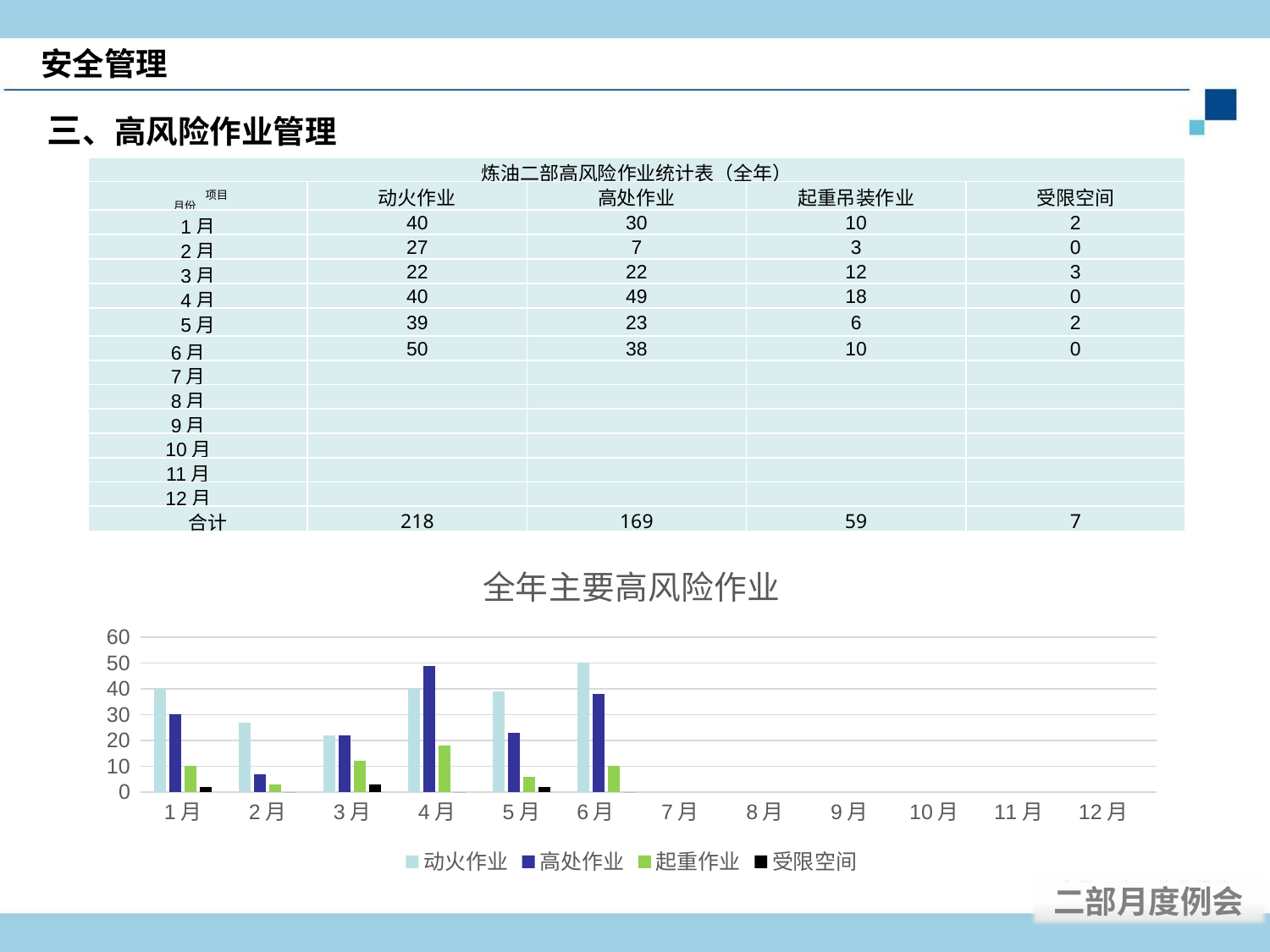
In the 全年主要高风险作业 chart, which month has the lowest 高处作业 value among the months with data? 2月 How many series does the legend of the 全年主要高风险作业 chart list? 4 What is the title of the chart on the slide? 全年主要高风险作业 In the 全年主要高风险作业 chart, for 4月, which is larger: 动火作业 or 高处作业? 高处作业 In the 全年主要高风险作业 chart, what is the value of 高处作业 for 4月? 49 In the 全年主要高风险作业 chart, which month has the highest 动火作业 value? 6月 In the 全年主要高风险作业 chart, is the 动火作业 value for 2月 greater or less than 30? less How many month categories are shown on the x axis of the 全年主要高风险作业 chart? 12 What kind of chart is shown under the title 全年主要高风险作业? bar chart In the 全年主要高风险作业 chart, does the 高处作业 value rise or fall from 2月 to 4月? rise In the 全年主要高风险作业 chart, what is the value of 动火作业 for 6月? 50 In the 全年主要高风险作业 chart, what is the difference between 高处作业 and 动火作业 for 4月? 9